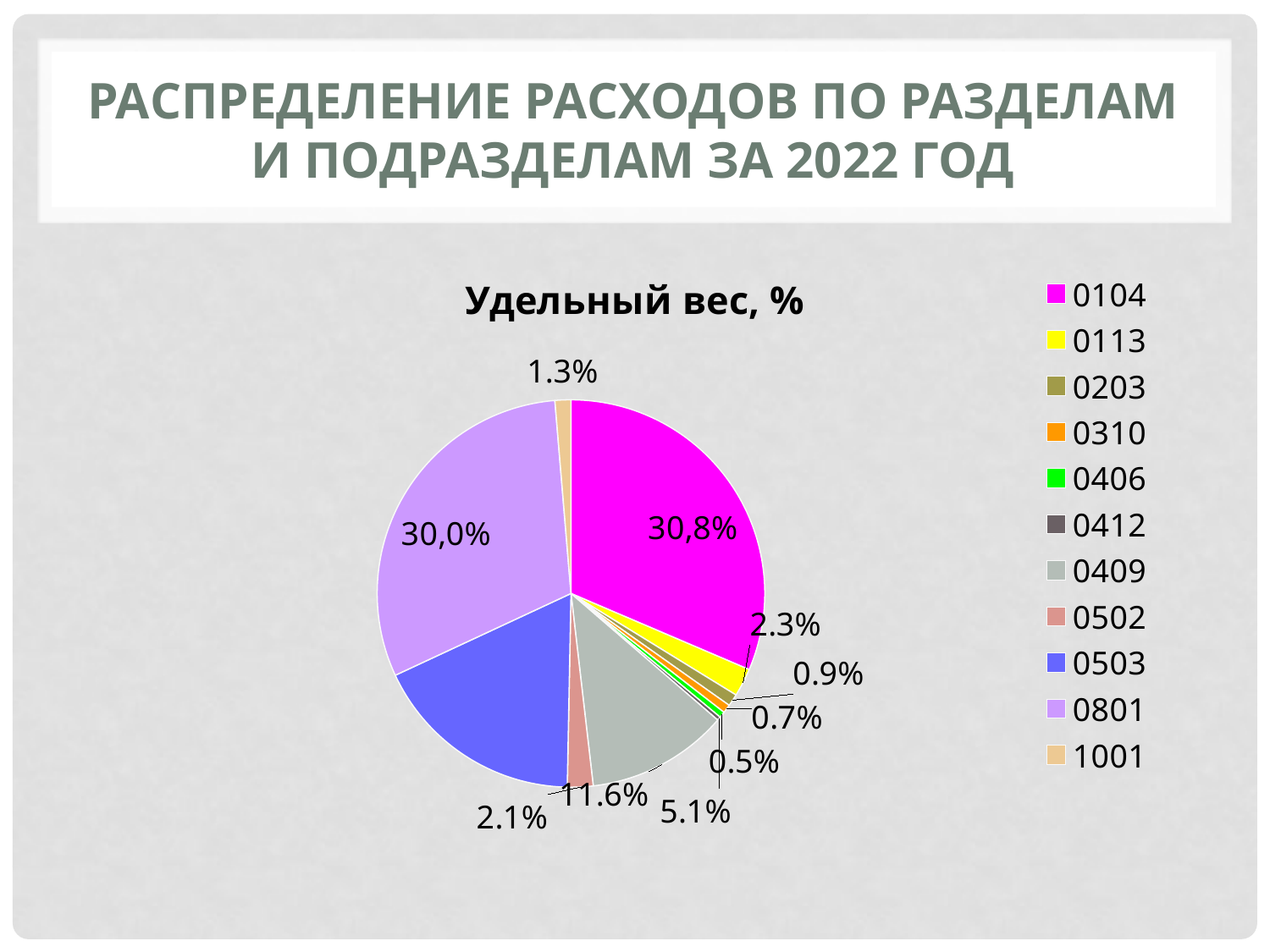
How many categories does the legend list? 11 What is the share for category 0104? 30,8% What is the share for category 0113? 2.3% What kind of chart is shown on the slide? pie chart What is the share for category 0409? 11.6% Which category has the largest share of the pie? 0104 Which is larger, the share for 0104 or the share for 0801? 0104 What is the share for category 0502? 2.1% What is the share for category 0801? 30,0% What is the title of the chart? Удельный вес, % What is the difference between the shares for 0104 and 0801? 0,8% What is the share for category 1001? 1.3%